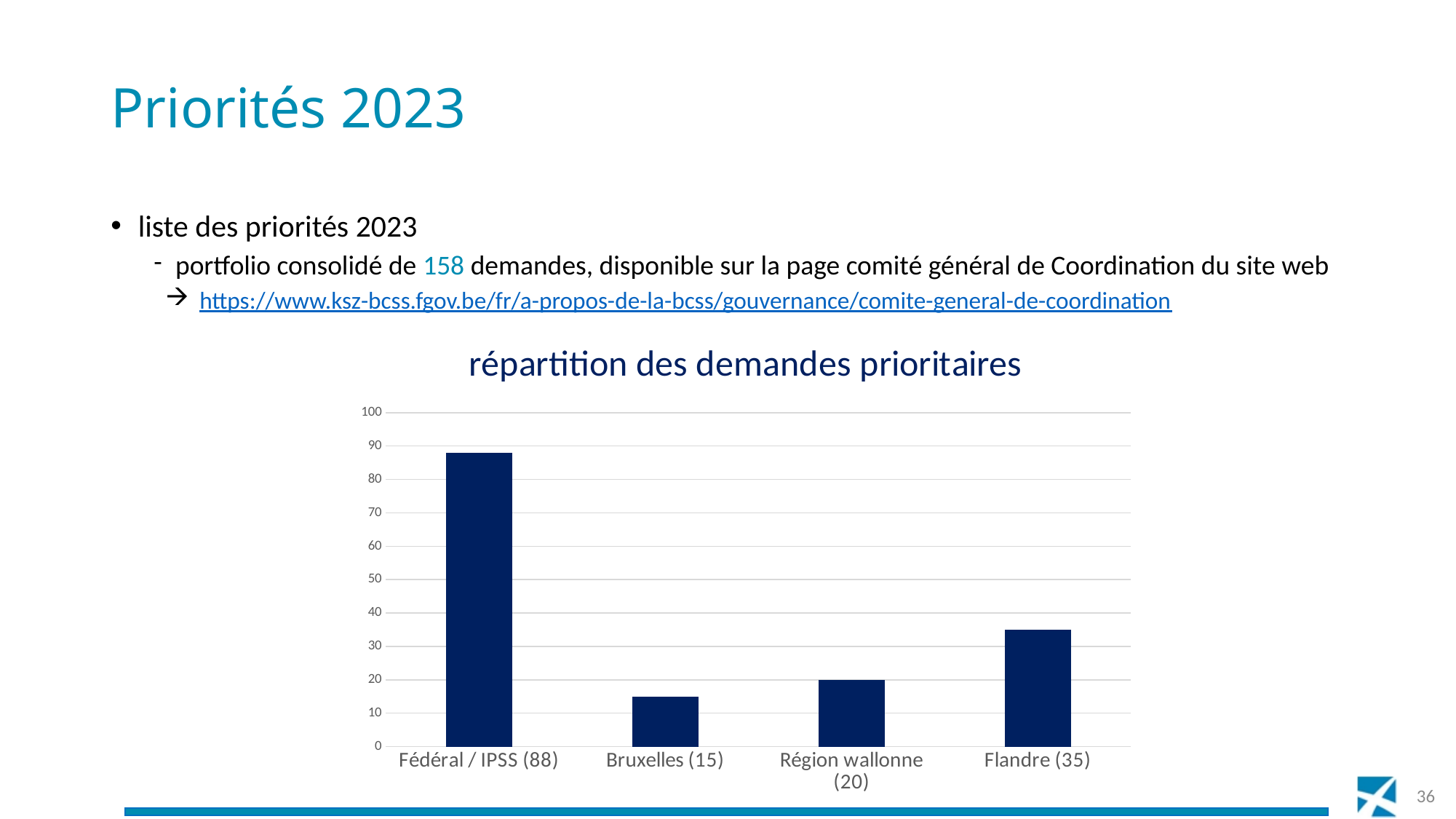
What kind of chart is shown on the slide? bar chart What is the title of the chart? répartition des demandes prioritaires Is the value for Flandre greater or less than 30? greater Which is larger, the value for Région wallonne or the value for Bruxelles? Région wallonne What is the value for Région wallonne in the chart? 20 Which category has the highest value in the chart? Fédéral / IPSS How many categories are shown in the chart? 4 What is the value for Fédéral / IPSS in the chart? 88 What is the value for Flandre in the chart? 35 What is the value for Bruxelles in the chart? 15 What is the difference between the values for Fédéral / IPSS and Flandre? 53 Which category has the lowest value in the chart? Bruxelles